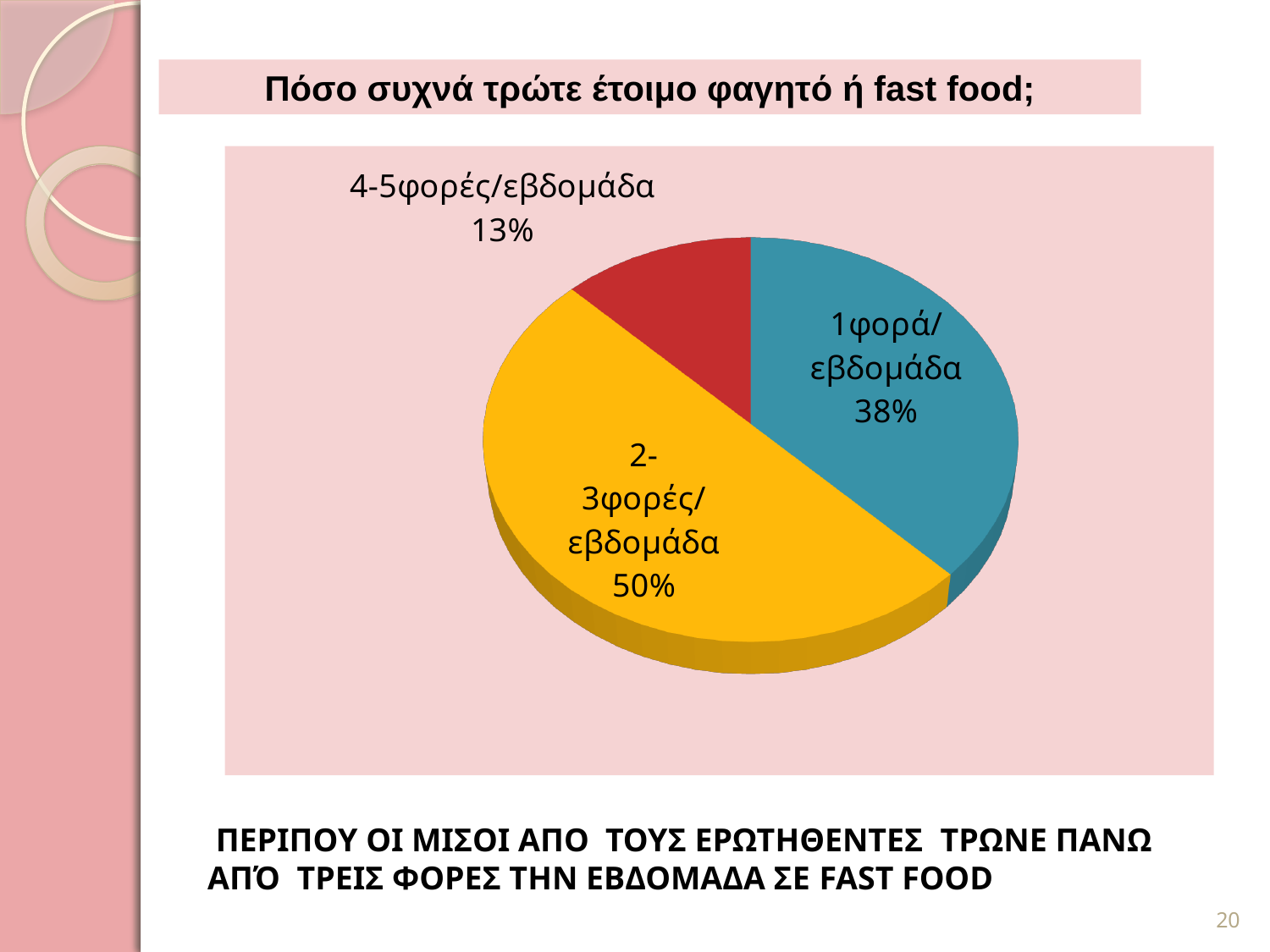
Which category has the smallest share of the pie? 4-5φορές/εβδομάδα What is the title of the slide above the chart? Πόσο συχνά τρώτε έτοιμο φαγητό ή fast food; Which slice is larger: '1φορά/εβδομάδα' or '4-5φορές/εβδομάδα'? 1φορά/εβδομάδα What colour is the '2-3φορές/εβδομάδα' slice? Yellow How many categories are shown in the pie chart? 3 What is the difference in percentage points between the '2-3φορές/εβδομάδα' slice and the '1φορά/εβδομάδα' slice? 12 What share of the pie does the '1φορά/εβδομάδα' slice represent? 38% What share of the pie does the '4-5φορές/εβδομάδα' slice represent? 13% Which category has the largest share of the pie? 2-3φορές/εβδομάδα What kind of chart is shown on the slide? Pie chart What share of the pie does the '2-3φορές/εβδομάδα' slice represent? 50% What is the difference in percentage points between the '1φορά/εβδομάδα' slice and the '4-5φορές/εβδομάδα' slice? 25